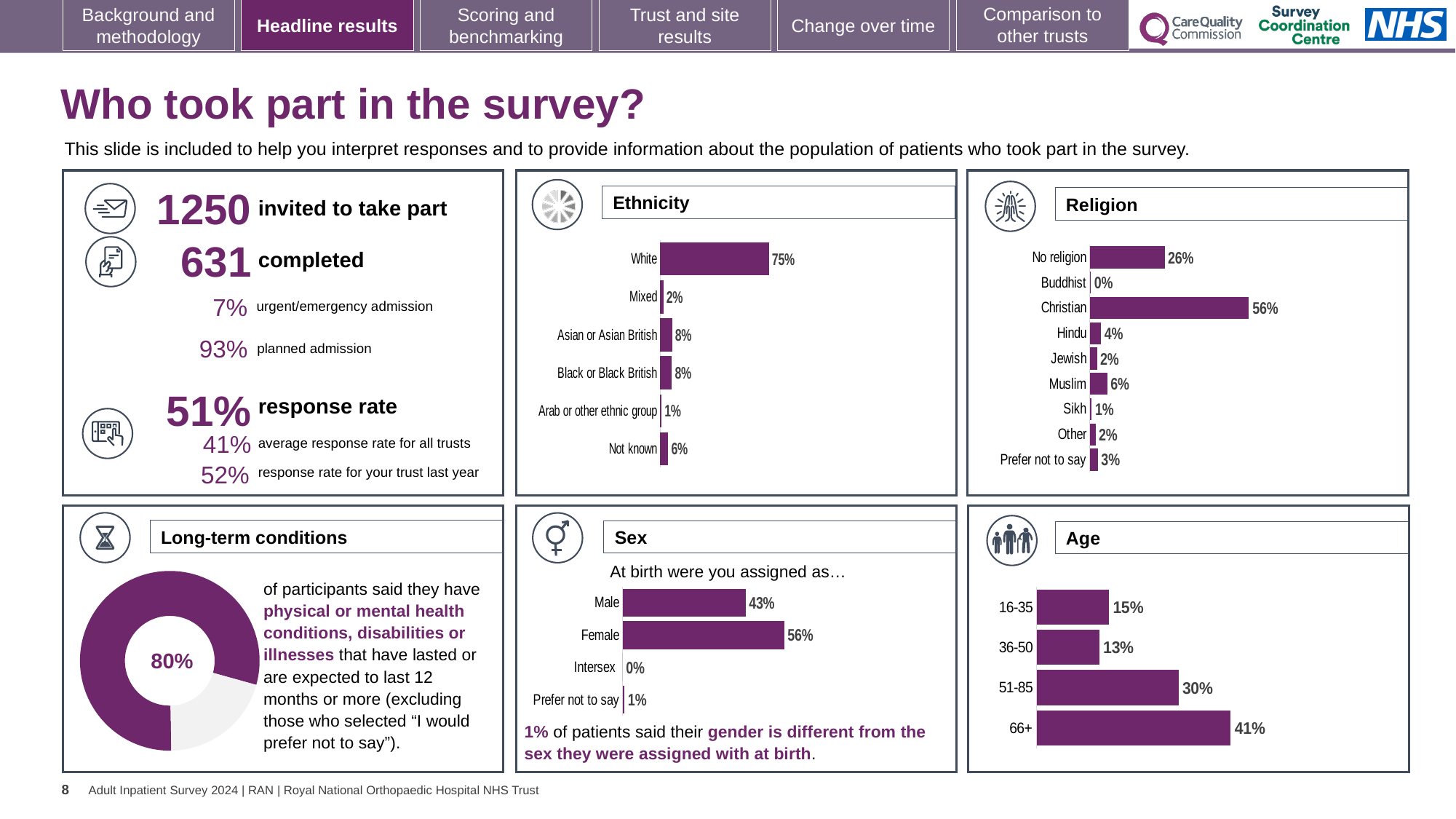
In the Religion chart, what percentage of participants were Christian? 56% In the Ethnicity chart, how many categories are shown? 6 In the Religion chart, how many categories are shown? 9 What kind of chart is used in the Long-term conditions panel? Doughnut chart In the Ethnicity chart, which category has the lowest value? Arab or other ethnic group In the Sex chart, which is larger, Male or Female? Female In the Age chart, what is the difference between the 66+ and 16-35 values? 26% In the Ethnicity chart, what percentage of participants were White? 75% In the Religion chart, what is the difference between the Christian and No religion values? 30% In the Sex chart, what percentage of participants answered Prefer not to say? 1% In the Religion chart, which category has the highest value? Christian In the Age chart, what percentage of participants were aged 66+? 41%